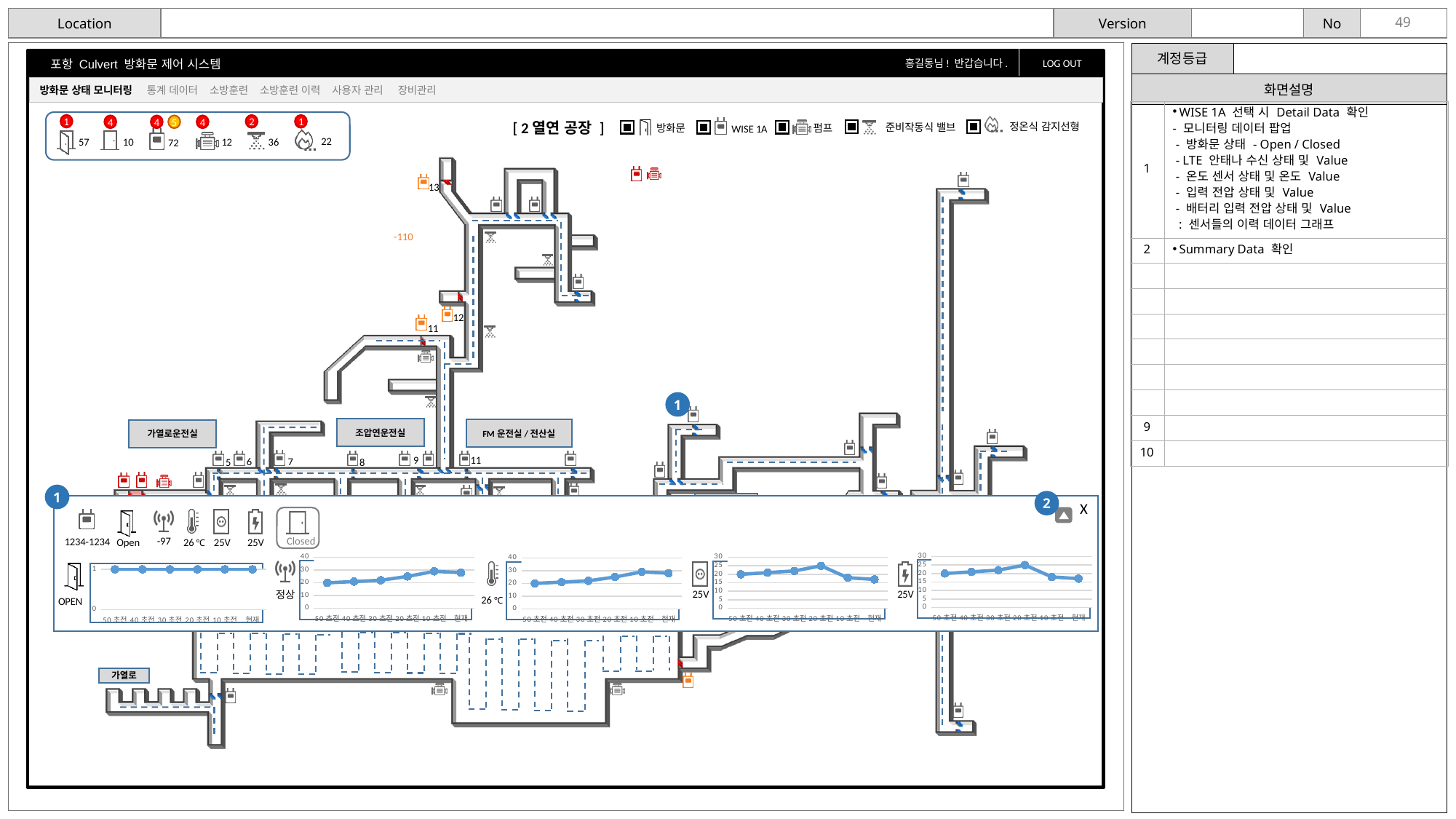
In the rightmost chart (battery voltage, 25V), is the value at 현재 greater or less than 20? less What is the label of the first x-axis point on the charts in the detail panel? 50 초전 In the antenna (LTE) chart, second from the left, do the values rise or fall from 50 초전 to 현재? rise What is the highest y-axis tick shown on the rightmost (battery) chart? 30 What kind of chart is the second chart from the left in the detail panel (next to the antenna icon)? line chart In the temperature chart, third from the left, is the value at 현재 greater or less than 20? greater How many small charts are shown in the detail panel at the bottom of the screen? 5 In the temperature chart, third from the left, do the values rise or fall from 50 초전 to 현재? rise What is the label of the last x-axis point on the charts in the detail panel? 현재 In the antenna (LTE) chart, second from the left, is the value at 현재 greater or less than 20? greater How many time points are plotted along the x axis of the temperature chart (third from the left)? 6